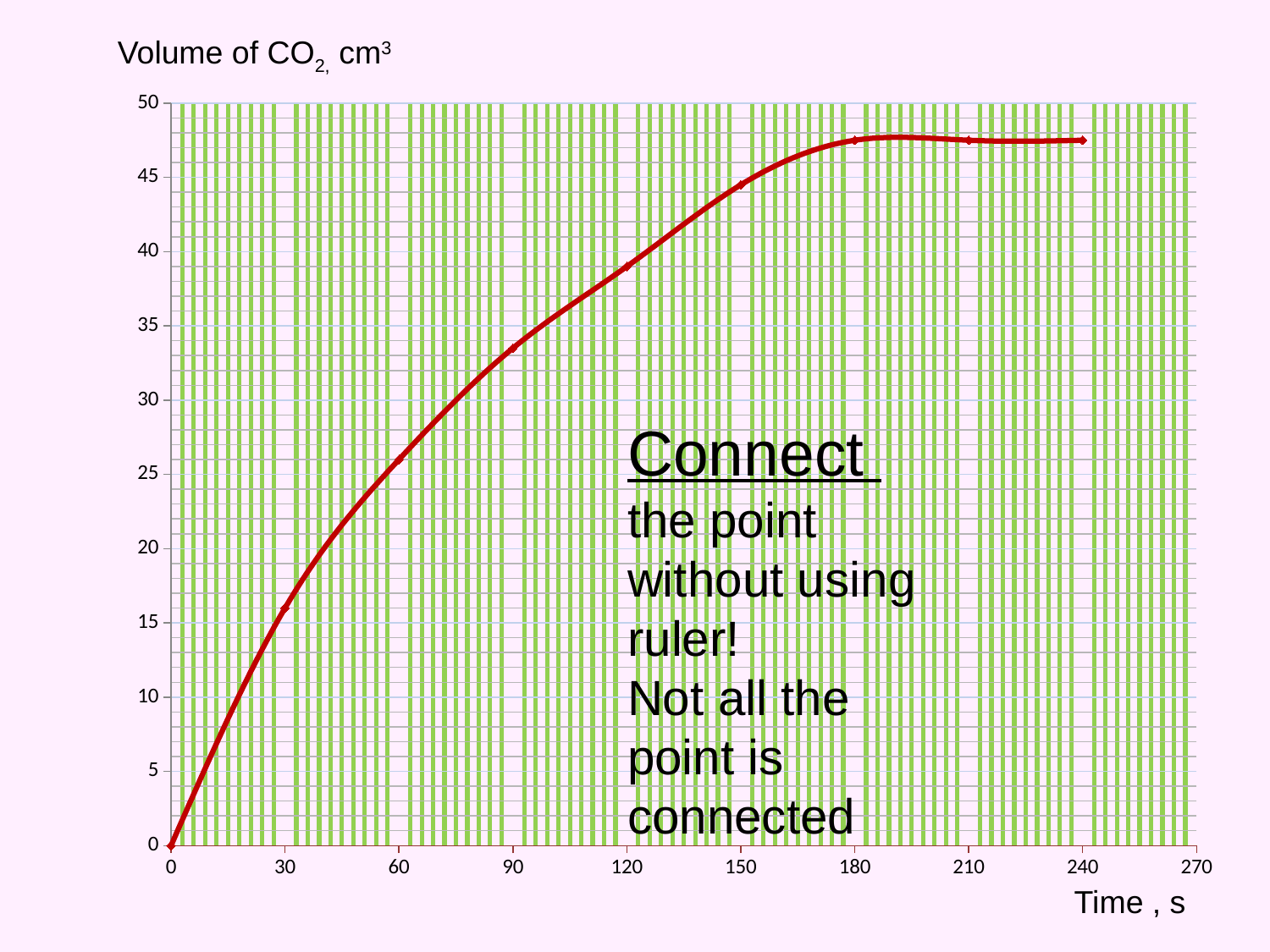
How many data points are plotted on the line? 9 What is the volume of CO2 at time 0 s? 0 Is the volume of CO2 at 240 s greater or less than 50? less Which is larger, the volume of CO2 at 60 s or at 120 s? 120 s Is the volume of CO2 at 180 s greater or less than 45? greater Is the volume of CO2 at 120 s greater or less than 40? less What kind of chart is shown on the slide? line chart How does the volume of CO2 change as time increases along the x axis? rises, then levels off At which time is the volume of CO2 lowest? 0 s